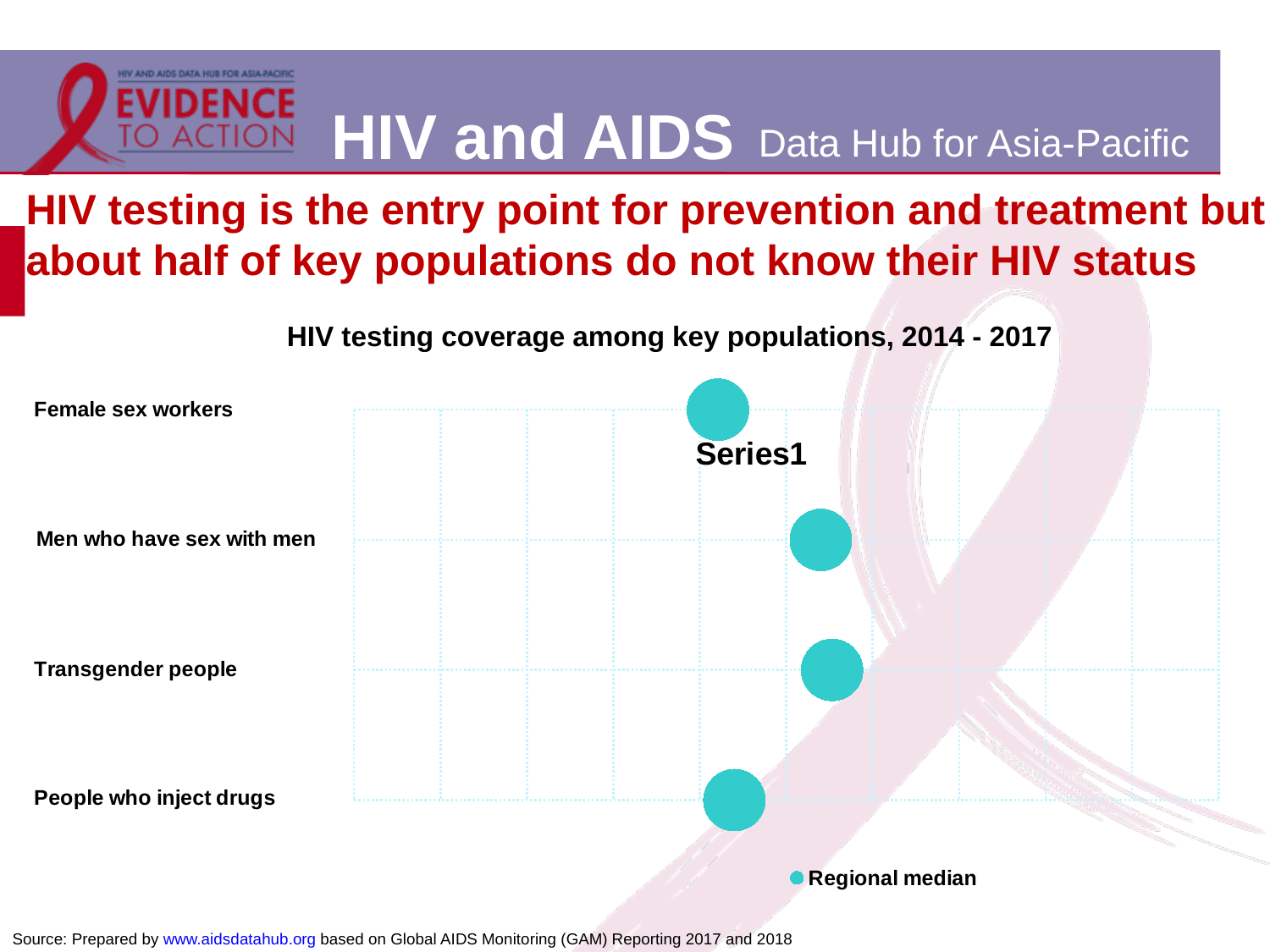
Which has the higher regional median HIV testing coverage: Transgender people or People who inject drugs? Transgender people Which has the higher regional median HIV testing coverage: Men who have sex with men or People who inject drugs? Men who have sex with men What is the title of the chart? HIV testing coverage among key populations, 2014 - 2017 Which has the higher regional median HIV testing coverage: Men who have sex with men or Female sex workers? Men who have sex with men How many series does the chart legend list? 1 What is the name of the series shown in the chart legend? Regional median What kind of chart is shown on the slide? Dot (scatter) chart How many key population categories are plotted in the chart? 4